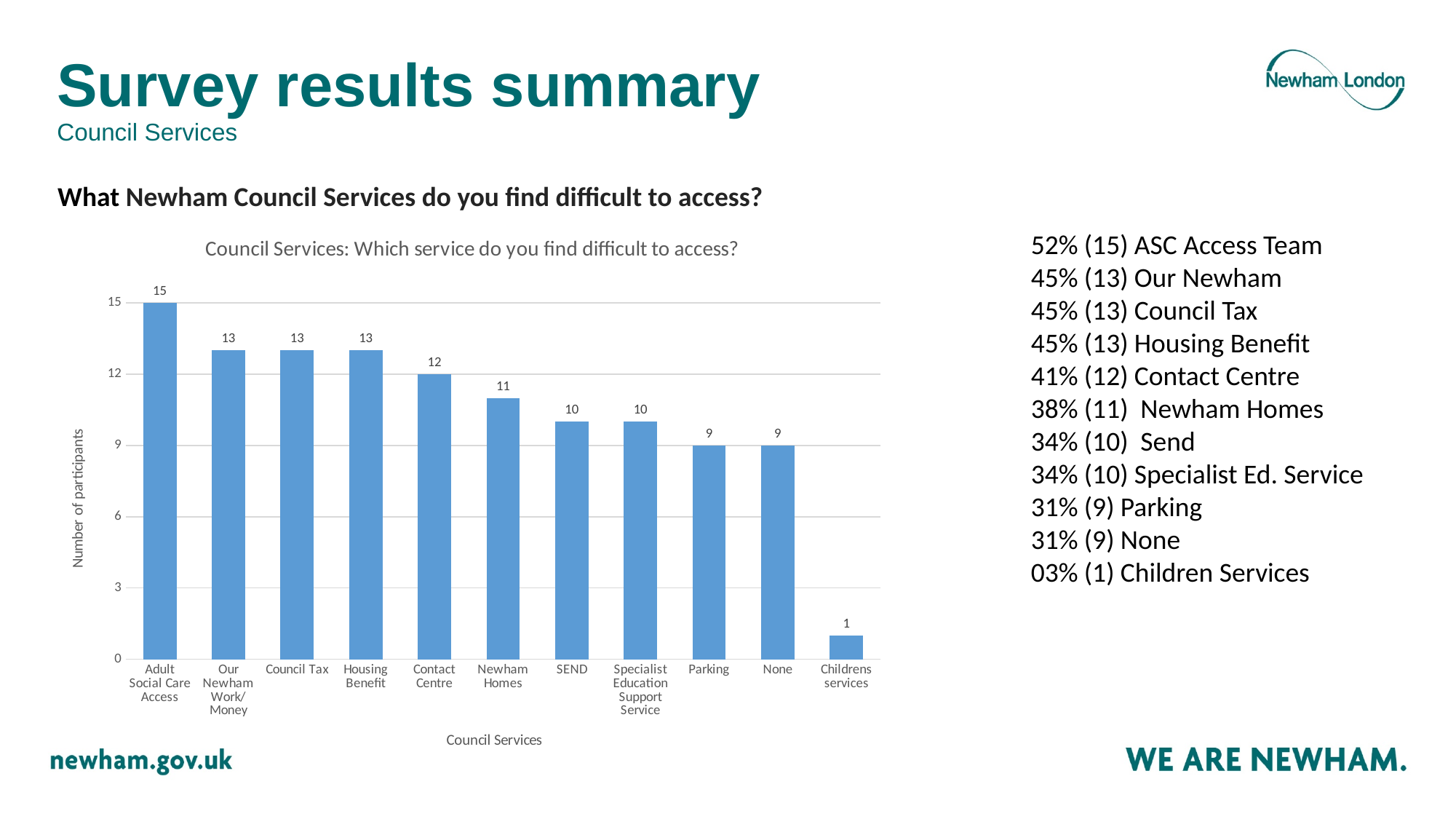
How many categories are shown on the x axis? 11 What is the value for Contact Centre? 12 What kind of chart is shown on the slide? Bar chart What is the value for Childrens services? 1 What is the value for Newham Homes? 11 Do the values generally rise or fall from left to right along the x axis? Fall Which category has the highest value? Adult Social Care Access Which is larger, the value for Contact Centre or the value for SEND? Contact Centre What is the value for Adult Social Care Access? 15 What is the difference between the values for Adult Social Care Access and Parking? 6 Which category has the lowest value? Childrens services What is the label of the y axis? Number of participants